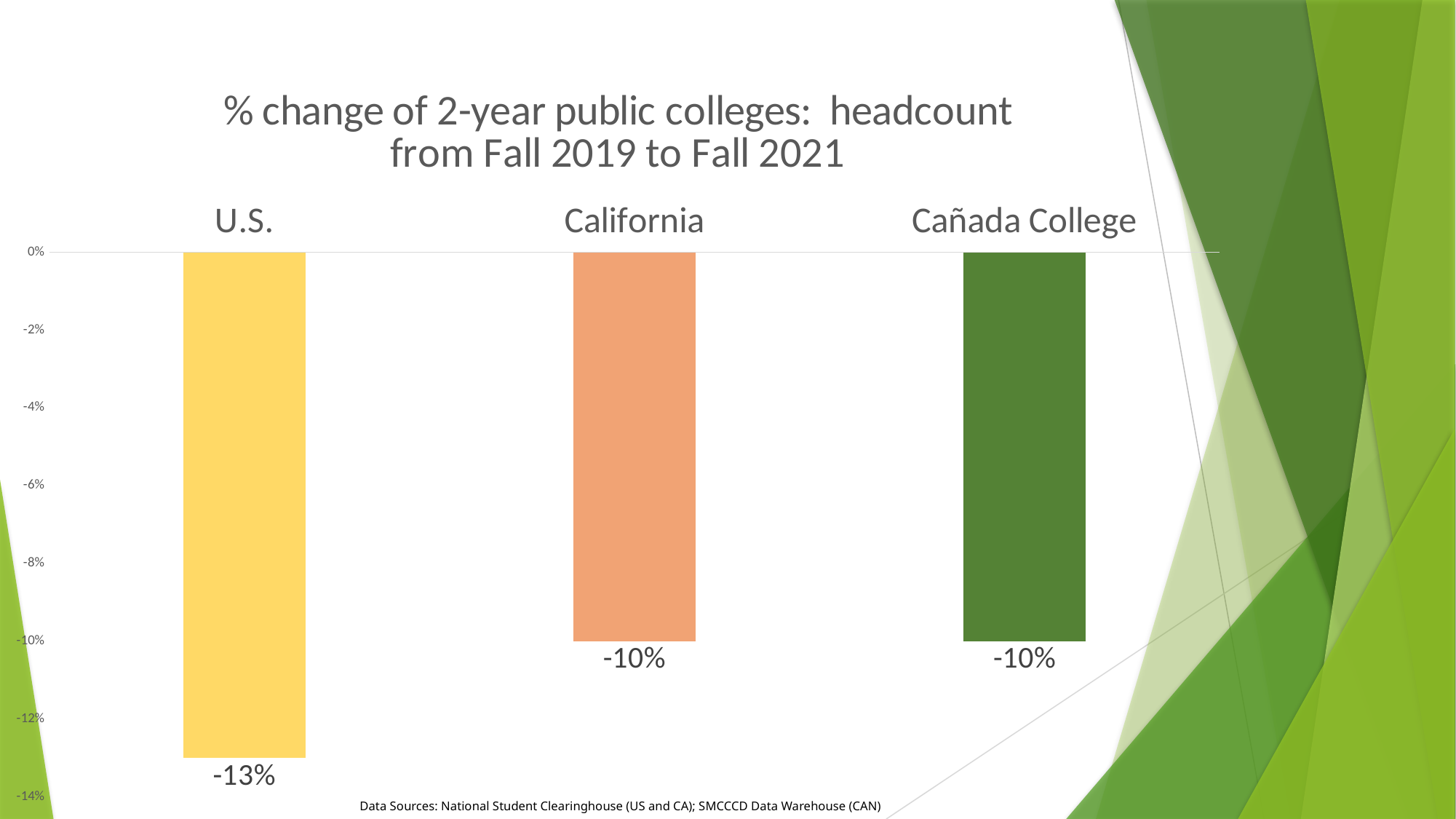
What colour is the bar for Cañada College? Green What is the % change in headcount for Cañada College? -10% Which category shows the largest decline in headcount? U.S. What is the % change in headcount for California? -10% Which has a larger decline in headcount, the U.S. or Cañada College? U.S. How many categories are shown in the chart? 3 Do California and Cañada College have the same % change in headcount? Yes Is the value for the U.S. greater or less than -12%? less What is the title of the chart? % change of 2-year public colleges: headcount from Fall 2019 to Fall 2021 What kind of chart is shown on the slide? Bar chart What is the % change in headcount for the U.S.? -13% What is the difference between the U.S. value and the California value? 3 percentage points